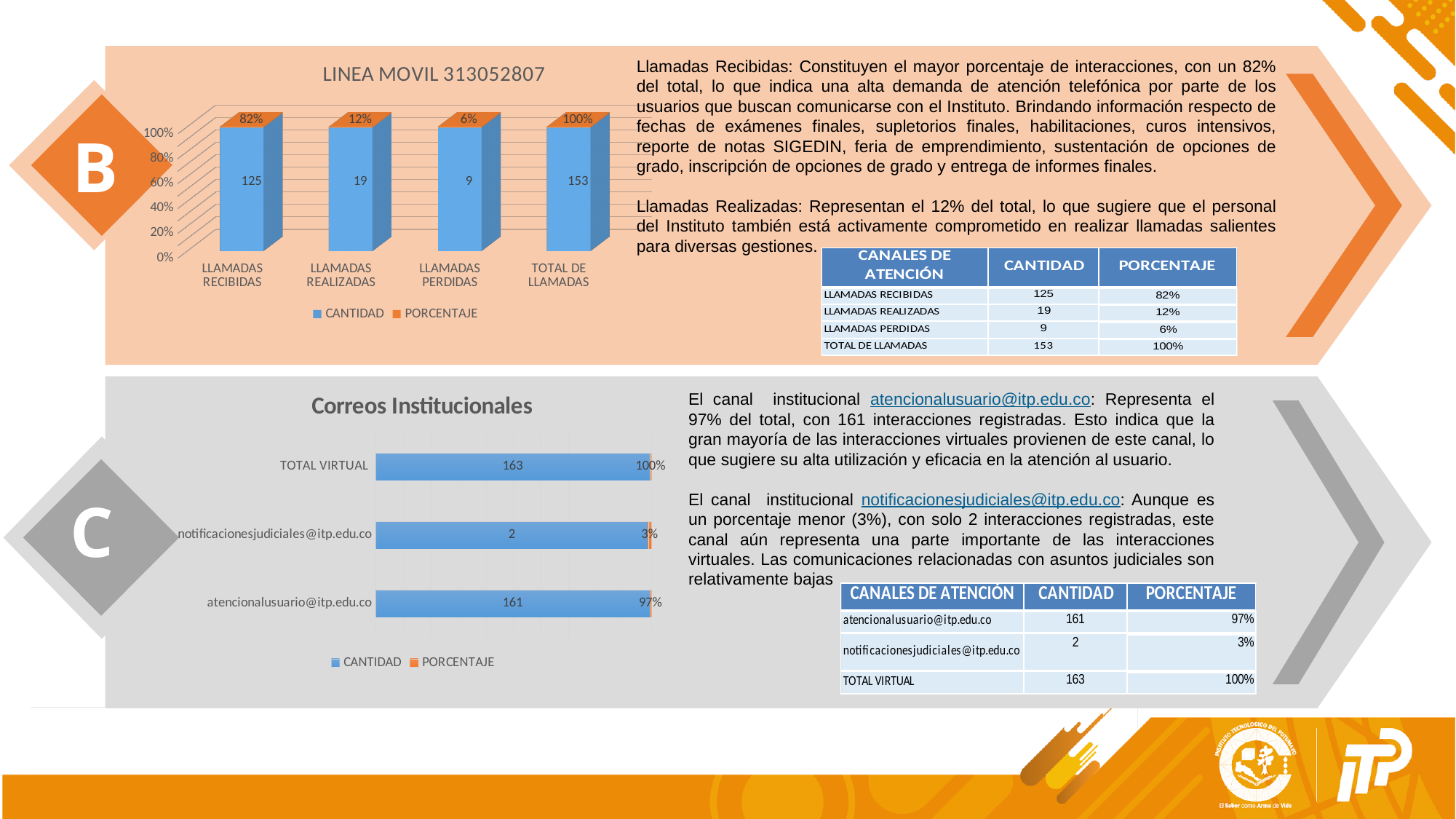
In the LINEA MOVIL 313052807 chart, which category has the lowest CANTIDAD value? LLAMADAS PERDIDAS In the Correos Institucionales chart, what PORCENTAJE is shown for notificacionesjudiciales@itp.edu.co? 3% How many categories are shown on the x axis of the LINEA MOVIL 313052807 chart? 4 How many series does the legend of the LINEA MOVIL 313052807 chart list? 2 In the LINEA MOVIL 313052807 chart, what PORCENTAJE is shown for LLAMADAS REALIZADAS? 12% In the Correos Institucionales chart, what is the CANTIDAD value for atencionalusuario@itp.edu.co? 161 In the Correos Institucionales chart, which has the larger CANTIDAD value: atencionalusuario@itp.edu.co or notificacionesjudiciales@itp.edu.co? atencionalusuario@itp.edu.co In the LINEA MOVIL 313052807 chart, what is the difference between the CANTIDAD values for LLAMADAS RECIBIDAS and LLAMADAS REALIZADAS? 106 What type of chart is the Correos Institucionales chart? Bar chart In the Correos Institucionales chart, what is the difference between the CANTIDAD values for TOTAL VIRTUAL and atencionalusuario@itp.edu.co? 2 In the LINEA MOVIL 313052807 chart, what is the CANTIDAD value for LLAMADAS RECIBIDAS? 125 In the LINEA MOVIL 313052807 chart, what is the CANTIDAD value for LLAMADAS PERDIDAS? 9